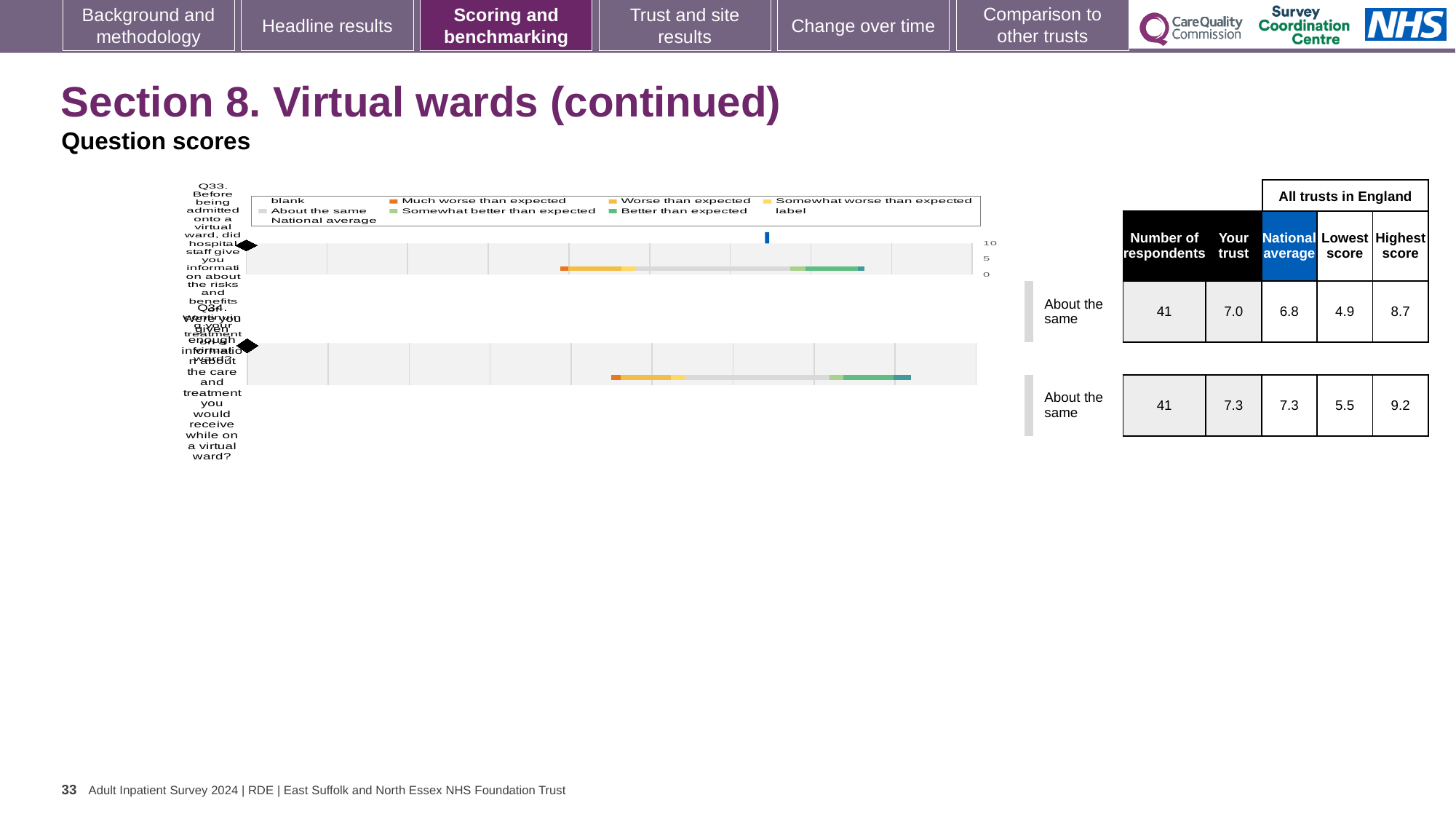
What is the national average score for Q34? 7.3 What is the lowest score among all trusts in England for Q33? 4.9 For Q33, which is larger: the 'Your trust' score or the national average? Your trust What kind of chart is shown on the slide? bar chart Which benchmark category is shown for Q34? About the same What is the difference between the highest and lowest scores for Q33? 3.8 What is the difference between the highest and lowest scores for Q34? 3.7 What is the 'Your trust' score for Q33? 7.0 What is the highest score among all trusts in England for Q34? 9.2 How many respondents answered Q33? 41 How many questions (rows) are plotted in the chart? 2 What colour does the legend use for 'Much worse than expected'? orange